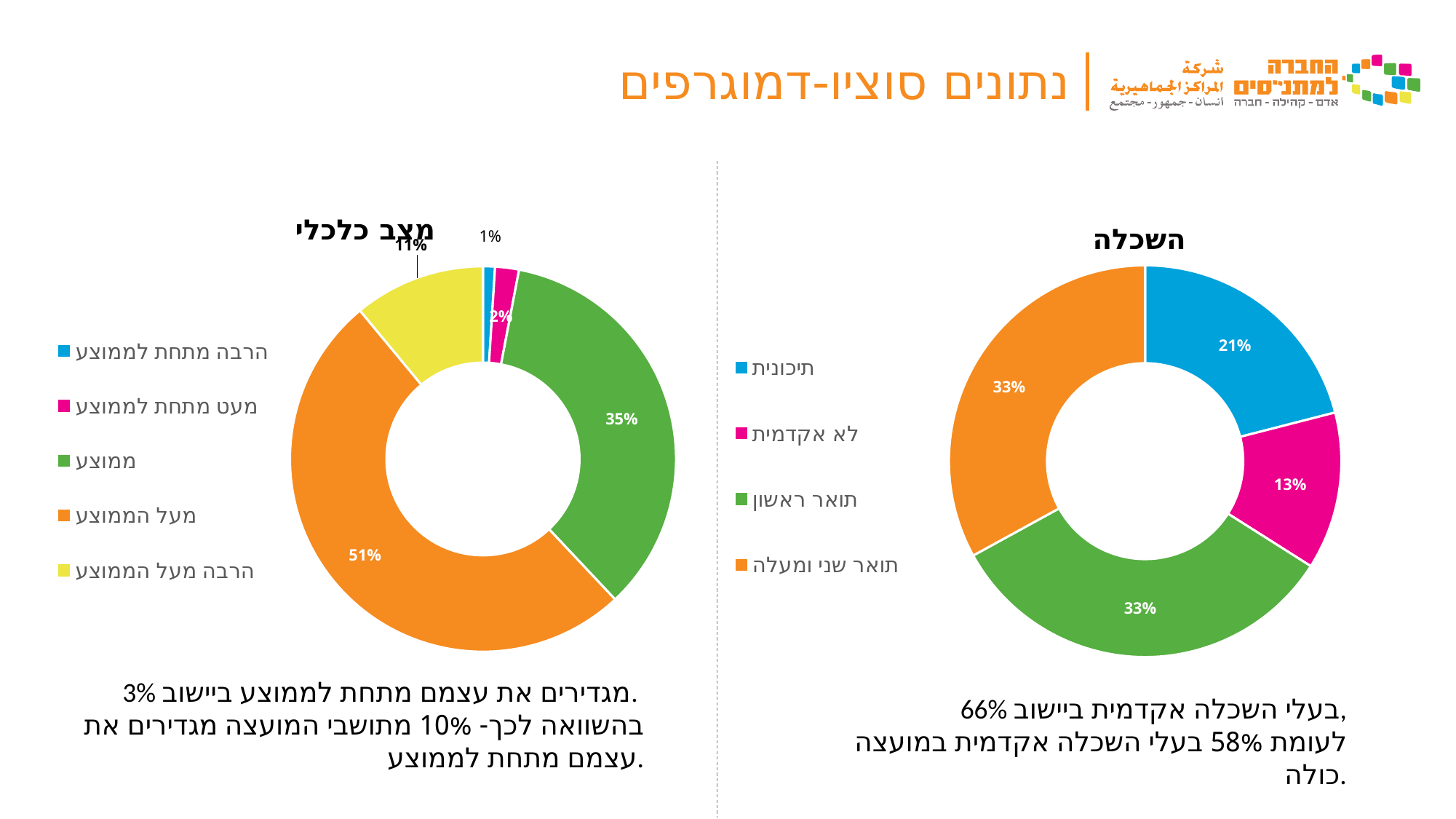
In the "מצב כלכלי" chart, which category has the largest share? מעל הממוצע In the "מצב כלכלי" chart, which category has the smallest share? הרבה מתחת לממוצע In the "מצב כלכלי" chart, what is the difference between the shares of "מעל הממוצע" and "ממוצע"? 16% In the "השכלה" chart, what percentage is shown for "תיכונית"? 21% In the "השכלה" chart, which category has the smallest share? לא אקדמית What type of chart is the "השכלה" chart? Pie (donut) chart In the "מצב כלכלי" chart, which is larger: the share for "ממוצע" or the share for "הרבה מעל הממוצע"? ממוצע In the "השכלה" chart, what is the difference between the shares of "תואר ראשון" and "תיכונית"? 12% In the "מצב כלכלי" chart, what percentage is shown for "הרבה מעל הממוצע"? 11% In the "השכלה" chart, what percentage is shown for "לא אקדמית"? 13% In the "השכלה" chart, how many categories does the legend list? 4 In the "מצב כלכלי" chart, what percentage is shown for "מעל הממוצע"? 51%